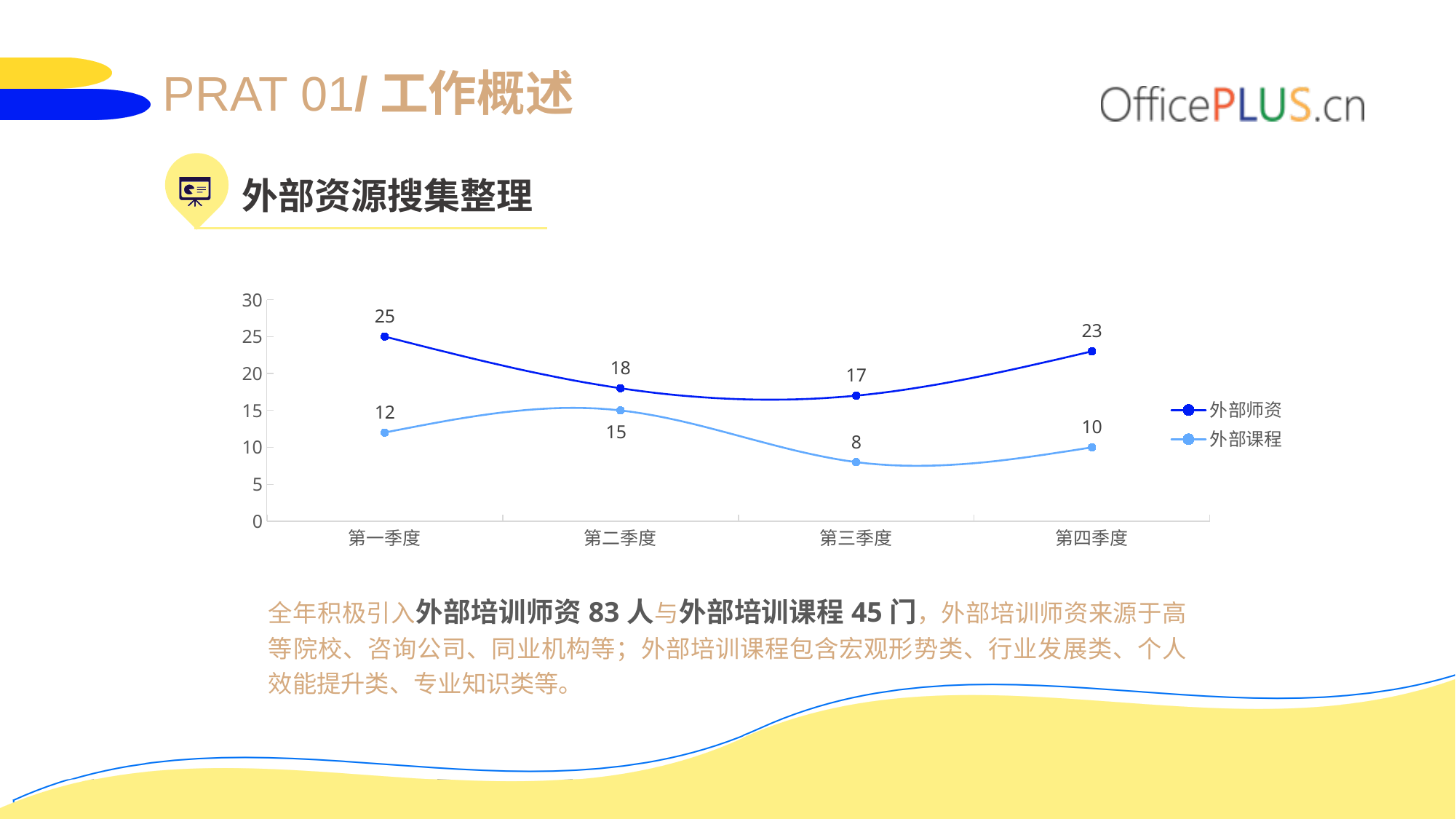
How many quarters are shown on the x axis? 4 What is the value for 外部课程 in 第三季度? 8 What is the difference between 外部师资 and 外部课程 in 第三季度? 9 How many series does the legend list? 2 Does 外部师资 rise or fall from 第一季度 to 第三季度? fall What is the value for 外部师资 in 第一季度? 25 Which is larger, 外部课程 in 第二季度 or 外部课程 in 第四季度? 第二季度 In which quarter is 外部课程 lowest? 第三季度 In which quarter is 外部师资 highest? 第一季度 What is the value for 外部师资 in 第四季度? 23 What is the difference between 外部师资 in 第一季度 and 第二季度? 7 What kind of chart is shown on the slide? line chart